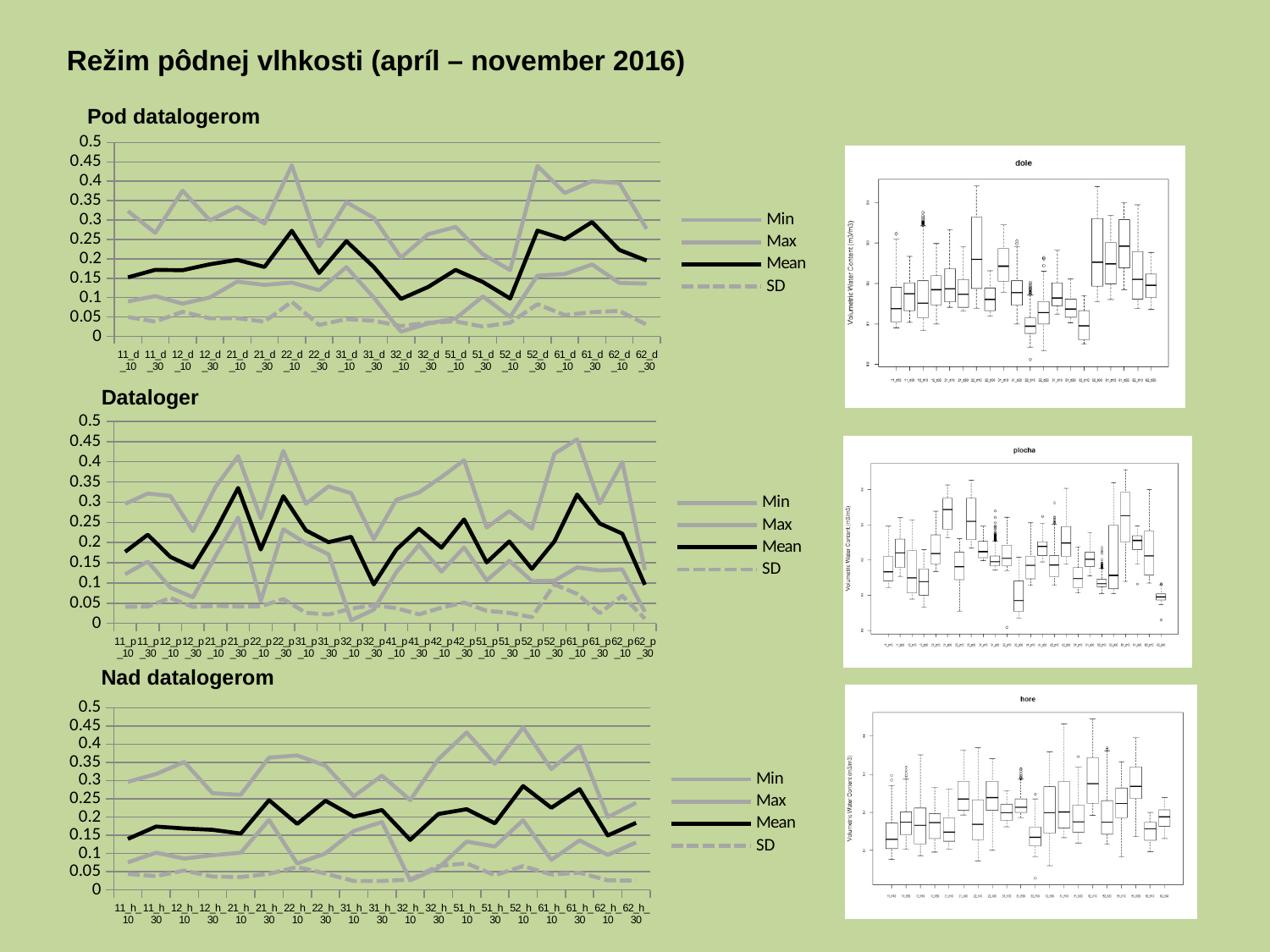
How many categories are on the x axis of the 'Dataloger' chart? 24 How many categories are on the x axis of the 'Pod datalogerom' chart? 20 In the 'Dataloger' chart, at which category does the Max series reach its highest value? 61_p_10 What kind of chart is the 'Pod datalogerom' chart? line chart What is the highest value shown on the y axis of the 'Nad datalogerom' chart? 0.5 What are the legend entries of the 'Nad datalogerom' chart? Min, Max, Mean, SD In the 'Pod datalogerom' chart, is the Mean value for 32_d_10 greater or less than 0.15? less In the 'Pod datalogerom' chart, which is larger: the Mean value for 61_d_30 or for 11_d_10? 61_d_30 In the 'Dataloger' chart, is the Max value for 61_p_10 greater or less than 0.4? greater In the 'Pod datalogerom' chart, is the Max value for 22_d_10 greater or less than 0.4? greater How many series does the legend of the 'Dataloger' chart list? 4